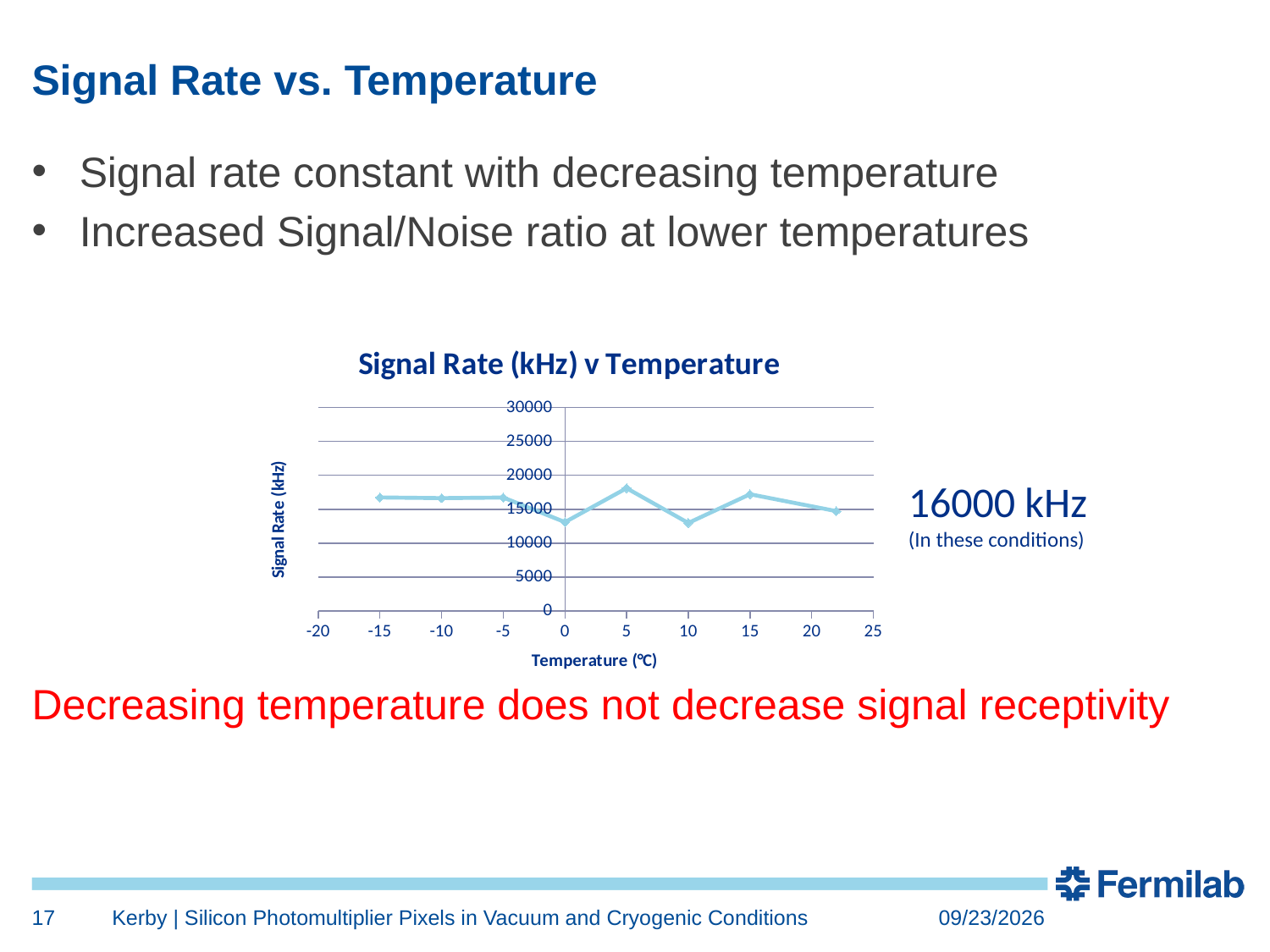
How many data points are plotted on the chart? 8 Is the signal rate at 10 °C greater or less than 15000? less Is the signal rate at 0 °C greater or less than 15000? less Is the signal rate at 5 °C larger or smaller than the signal rate at 10 °C? larger What is the title of the chart? Signal Rate (kHz) v Temperature Is the signal rate at 0 °C greater or less than 10000? greater What is the label of the x axis of the chart? Temperature (°C) At which temperature is the plotted signal rate highest? 5 °C What kind of chart is shown on the slide? line chart